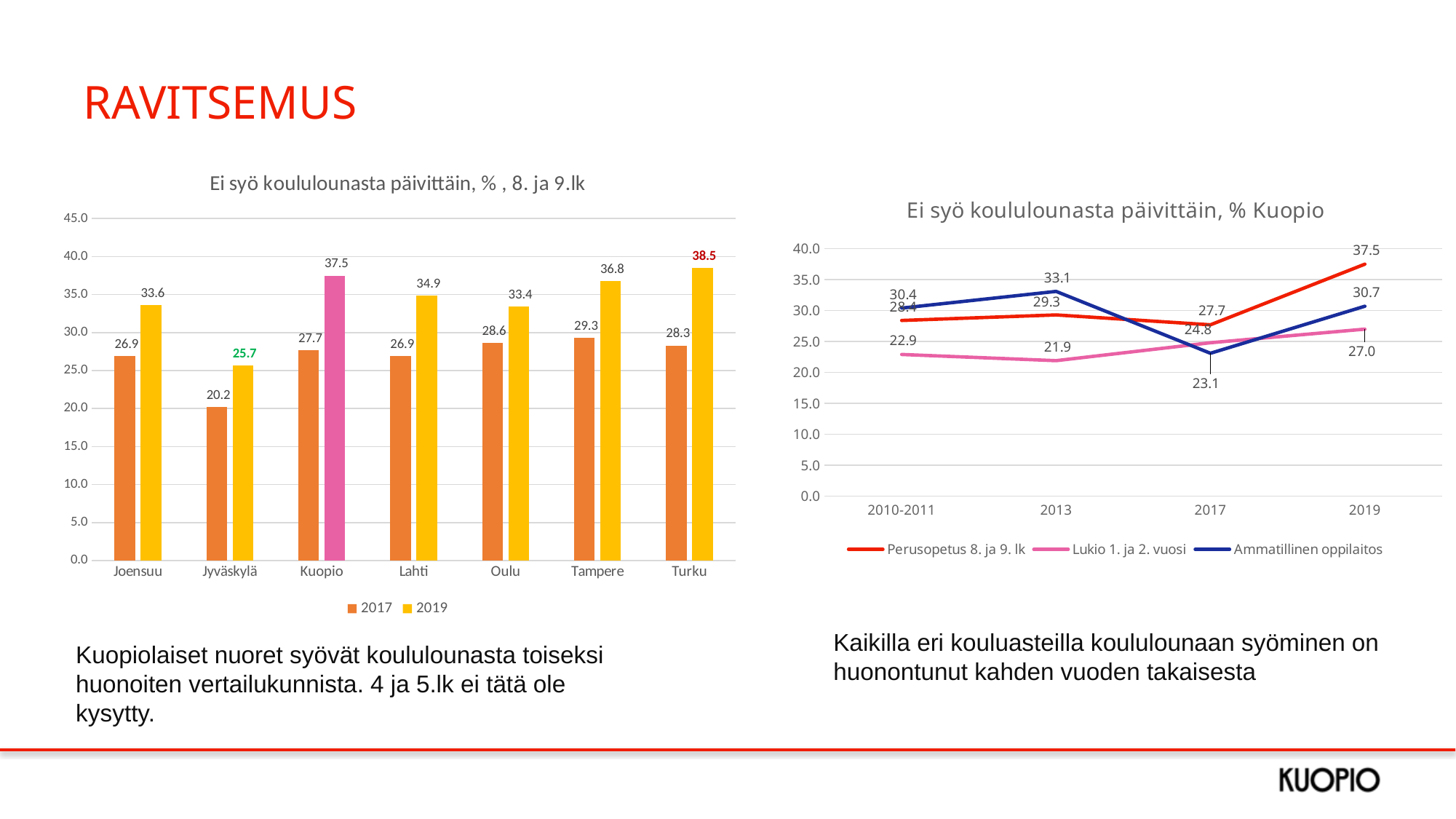
In the right chart 'Ei syö koululounasta päivittäin, % Kuopio', which is larger in 2013: Ammatillinen oppilaitos or Lukio 1. ja 2. vuosi? Ammatillinen oppilaitos In the left chart 'Ei syö koululounasta päivittäin, % , 8. ja 9.lk', what is the 2019 value for Kuopio? 37.5 In the right chart 'Ei syö koululounasta päivittäin, % Kuopio', what is the value for Ammatillinen oppilaitos in 2017? 23.1 In the left chart 'Ei syö koululounasta päivittäin, % , 8. ja 9.lk', how many cities are shown on the x axis? 7 In the right chart 'Ei syö koululounasta päivittäin, % Kuopio', does the Lukio 1. ja 2. vuosi line rise or fall from 2013 to 2019? Rise In the right chart 'Ei syö koululounasta päivittäin, % Kuopio', what is the value for Lukio 1. ja 2. vuosi in 2019? 27.0 In the left chart 'Ei syö koululounasta päivittäin, % , 8. ja 9.lk', what is the 2017 value for Jyväskylä? 20.2 In the left chart 'Ei syö koululounasta päivittäin, % , 8. ja 9.lk', which city has the lowest 2017 value? Jyväskylä In the left chart 'Ei syö koululounasta päivittäin, % , 8. ja 9.lk', what kind of chart is it? Bar chart In the left chart 'Ei syö koululounasta päivittäin, % , 8. ja 9.lk', which city has the highest 2019 value? Turku In the right chart 'Ei syö koululounasta päivittäin, % Kuopio', how many series does the legend list? 3 In the left chart 'Ei syö koululounasta päivittäin, % , 8. ja 9.lk', what is the difference between the 2019 and 2017 values for Kuopio? 9.8